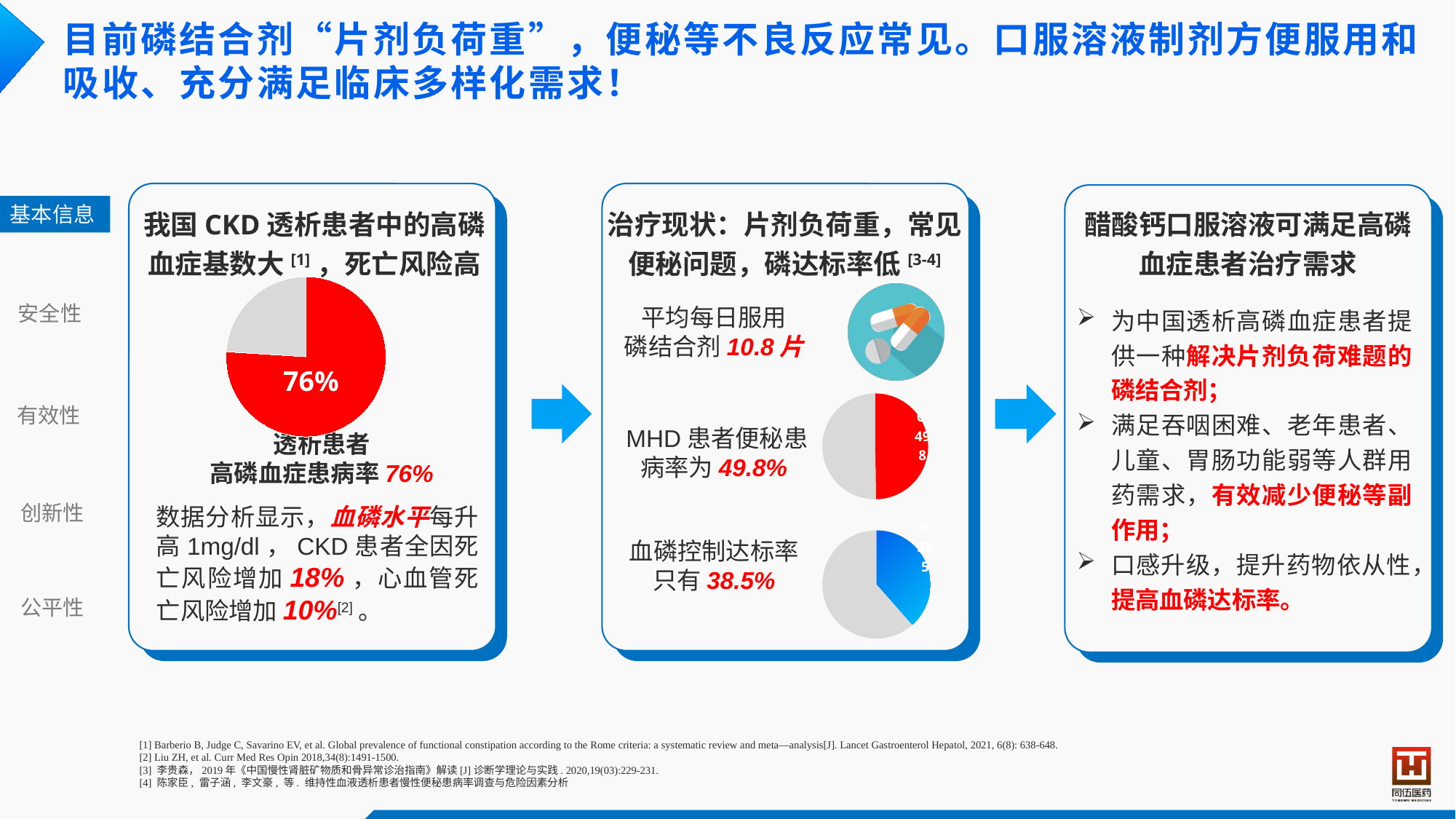
How many pie charts are shown on the slide in total? 3 In the left pie chart, what colour is the 76% slice? red Is the MHD constipation prevalence shown in the middle panel's upper pie chart greater or less than 50%? less What kind of chart is shown in the left panel under the heading about CKD dialysis patients? pie chart In the middle panel, what is the blood phosphorus control attainment rate shown by the lower pie chart? 38.5% In the middle panel, which is larger: the MHD constipation prevalence or the blood phosphorus control attainment rate? MHD constipation prevalence (49.8%) In the middle panel, what colour is the 38.5% slice of the lower pie chart? blue In the left pie chart, what share of dialysis patients have hyperphosphatemia (高磷血症患病率)? 76% In the middle panel, what is the constipation prevalence among MHD patients shown by the upper pie chart? 49.8% How many slices does the left pie chart have? 2 In the middle panel, what is the difference between the MHD constipation prevalence (49.8%) and the blood phosphorus control attainment rate (38.5%)? 11.3 percentage points What kind of chart is used in the middle panel to show the blood phosphorus control attainment rate? pie chart